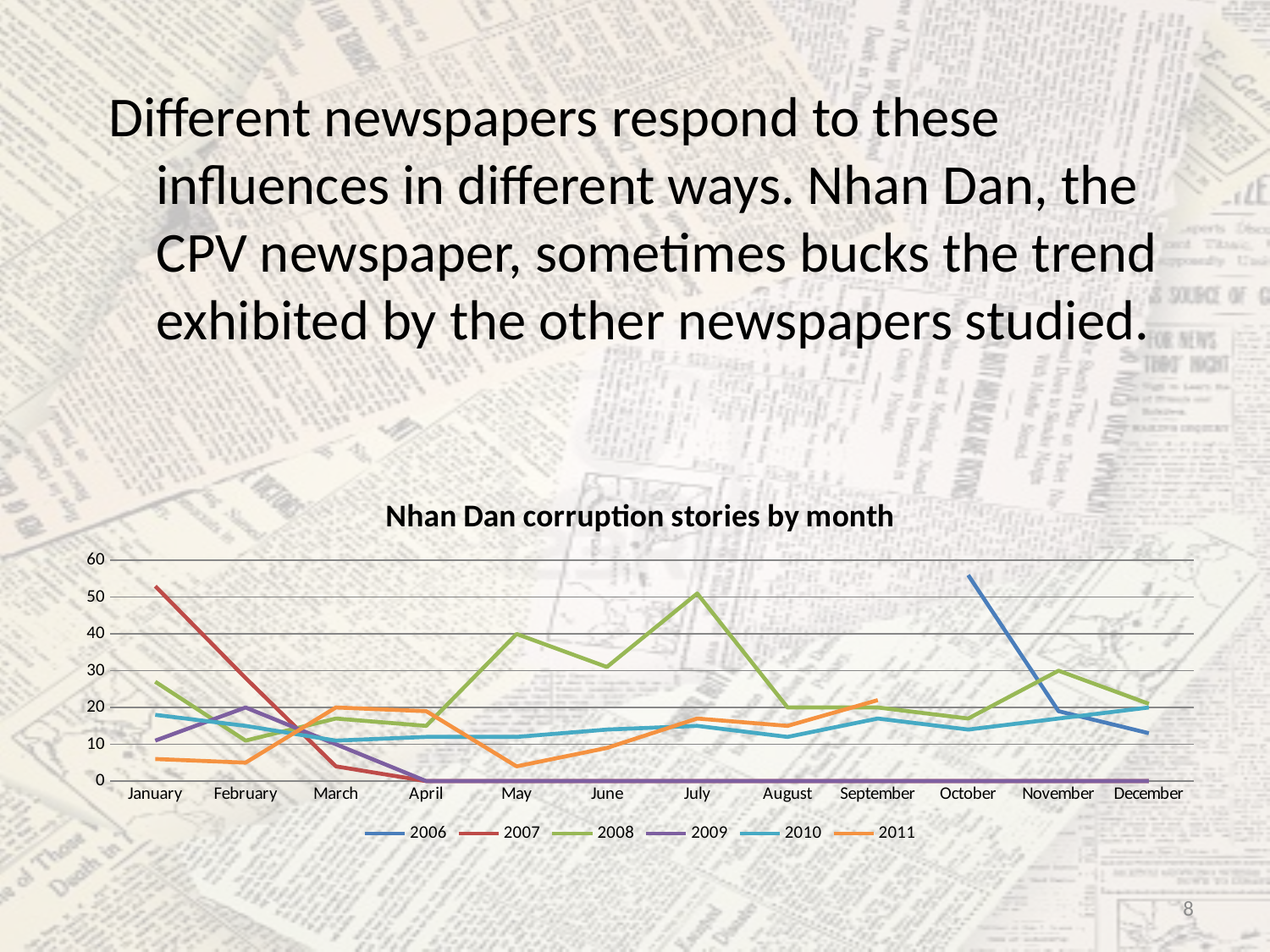
Which series has the higher value in July, 2008 or 2010? 2008 Is the value for 2011 in May greater or less than 10? less What kind of chart is shown on the slide? line chart Is the value for 2008 in May greater or less than 30? greater Is the value for 2006 in October greater or less than 50? greater How many series does the chart's legend list? 6 How many months are shown along the x axis of the chart? 12 Which series has the higher value in January, 2007 or 2011? 2007 What is the title of the chart? Nhan Dan corruption stories by month Does the 2007 series rise or fall from January to April? fall In which month does the 2008 series reach its highest value? July